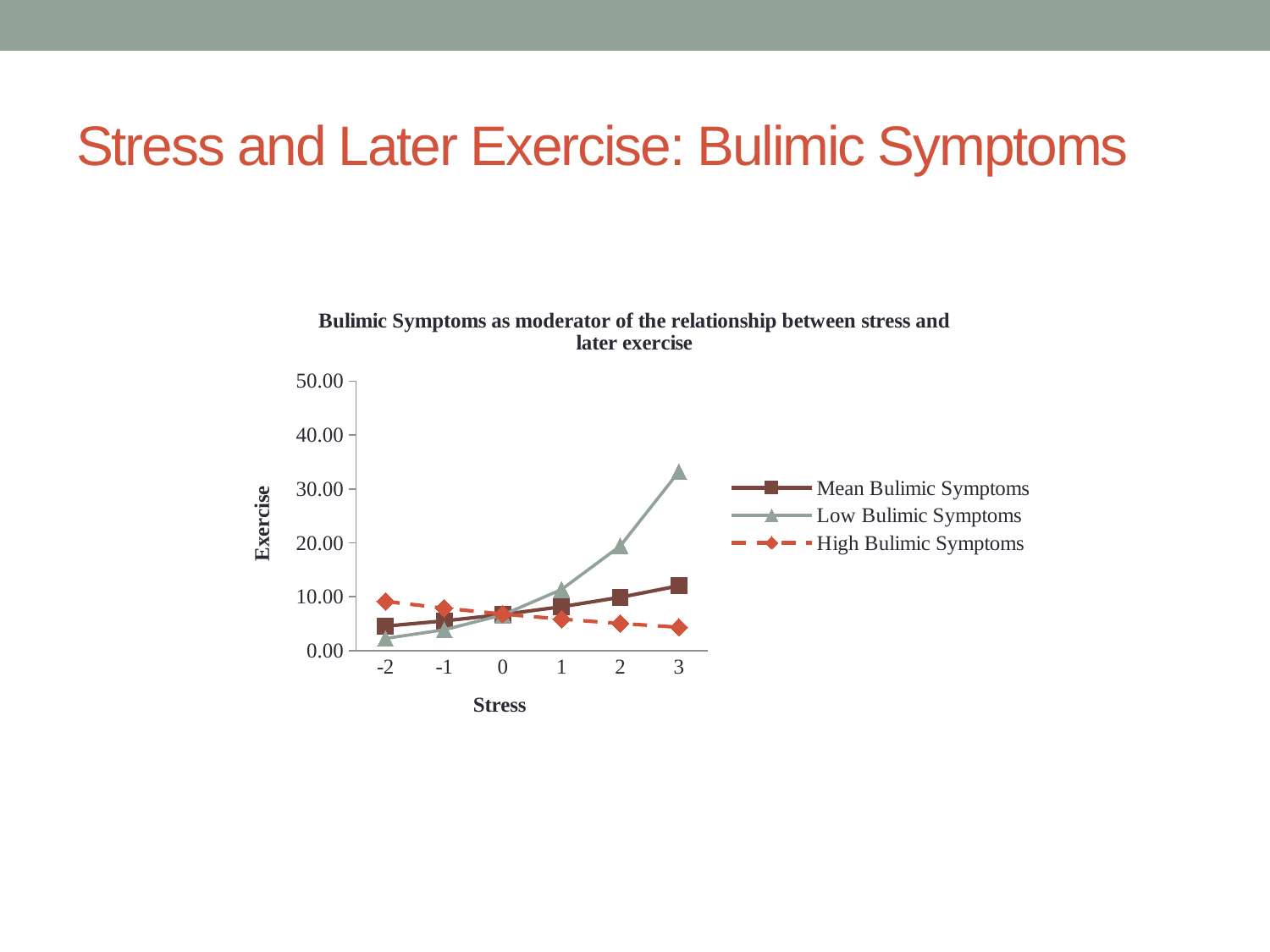
Which series has the highest Exercise value at Stress 3? Low Bulimic Symptoms How many series does the legend list? 3 Which series has the lowest Exercise value at Stress -2? Low Bulimic Symptoms Which series has the highest Exercise value at Stress -2? High Bulimic Symptoms Is the Exercise value for Low Bulimic Symptoms at Stress -2 greater or less than 10.00? less What kind of chart is shown on the slide? line chart What is the label on the vertical axis of the chart? Exercise Does the Exercise value for Low Bulimic Symptoms rise or fall as Stress increases from -2 to 3? rise Does the Exercise value for High Bulimic Symptoms rise or fall as Stress increases from -2 to 3? fall Is the Exercise value for Low Bulimic Symptoms at Stress 3 greater or less than 20.00? greater Is the Exercise value for High Bulimic Symptoms at Stress 3 greater or less than 10.00? less How many Stress values are plotted along the x axis? 6